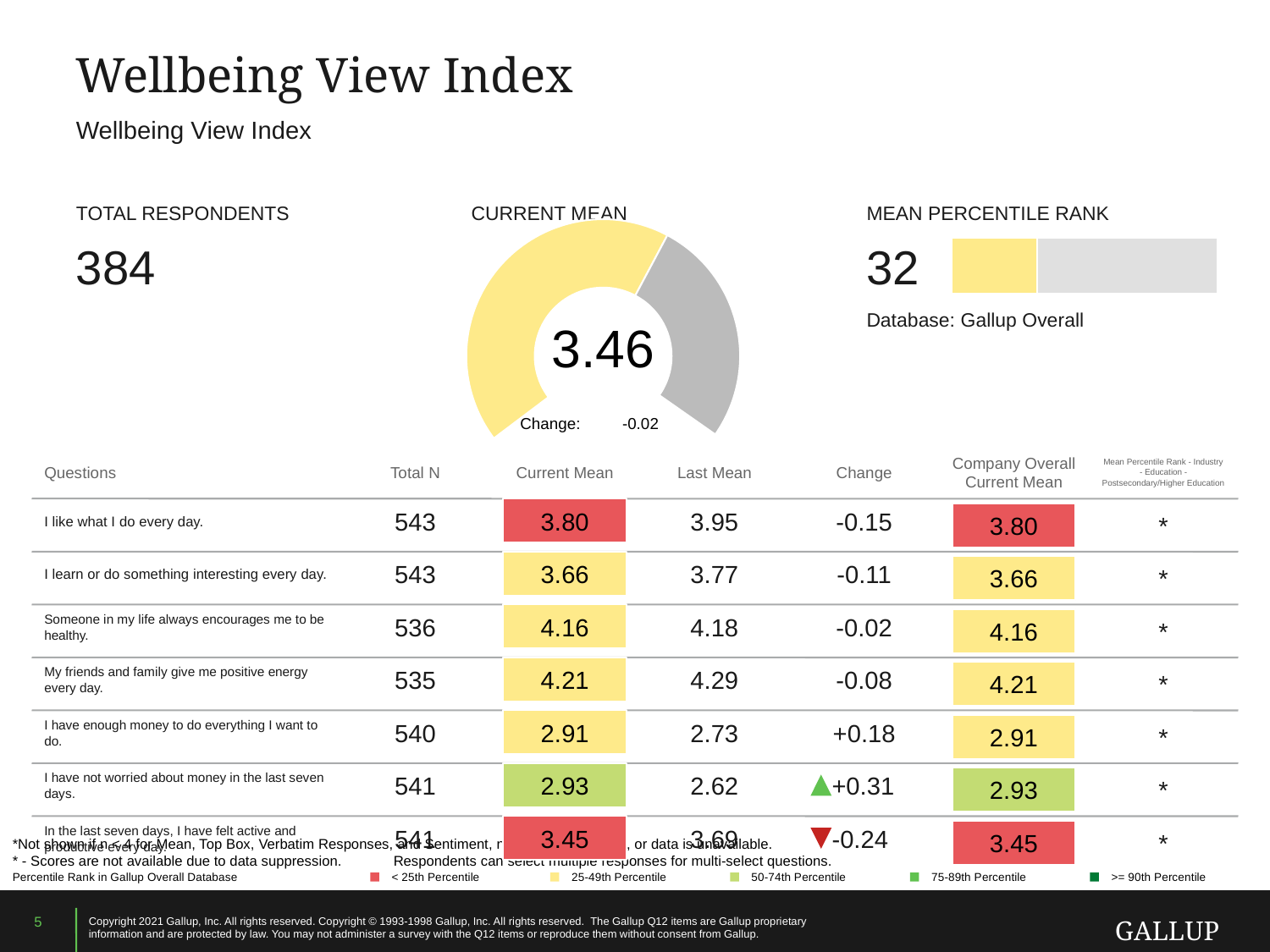
Is the Current Mean shown in the gauge chart greater or less than 3? greater Did the Current Mean rise or fall compared with the last period, according to the change shown under the gauge? fall What is the Total Respondents figure shown to the left of the Current Mean gauge? 384 Is the Mean Percentile Rank value greater or less than 50? less What is the Mean Percentile Rank value shown next to the percentile bar? 32 What colour is the filled portion of the Current Mean gauge? yellow What change value is shown below the Current Mean gauge? -0.02 What kind of chart is used to display the Current Mean of 3.46? gauge (doughnut) chart What is the current mean shown in the centre of the gauge chart? 3.46 What database is named under the Mean Percentile Rank chart? Gallup Overall